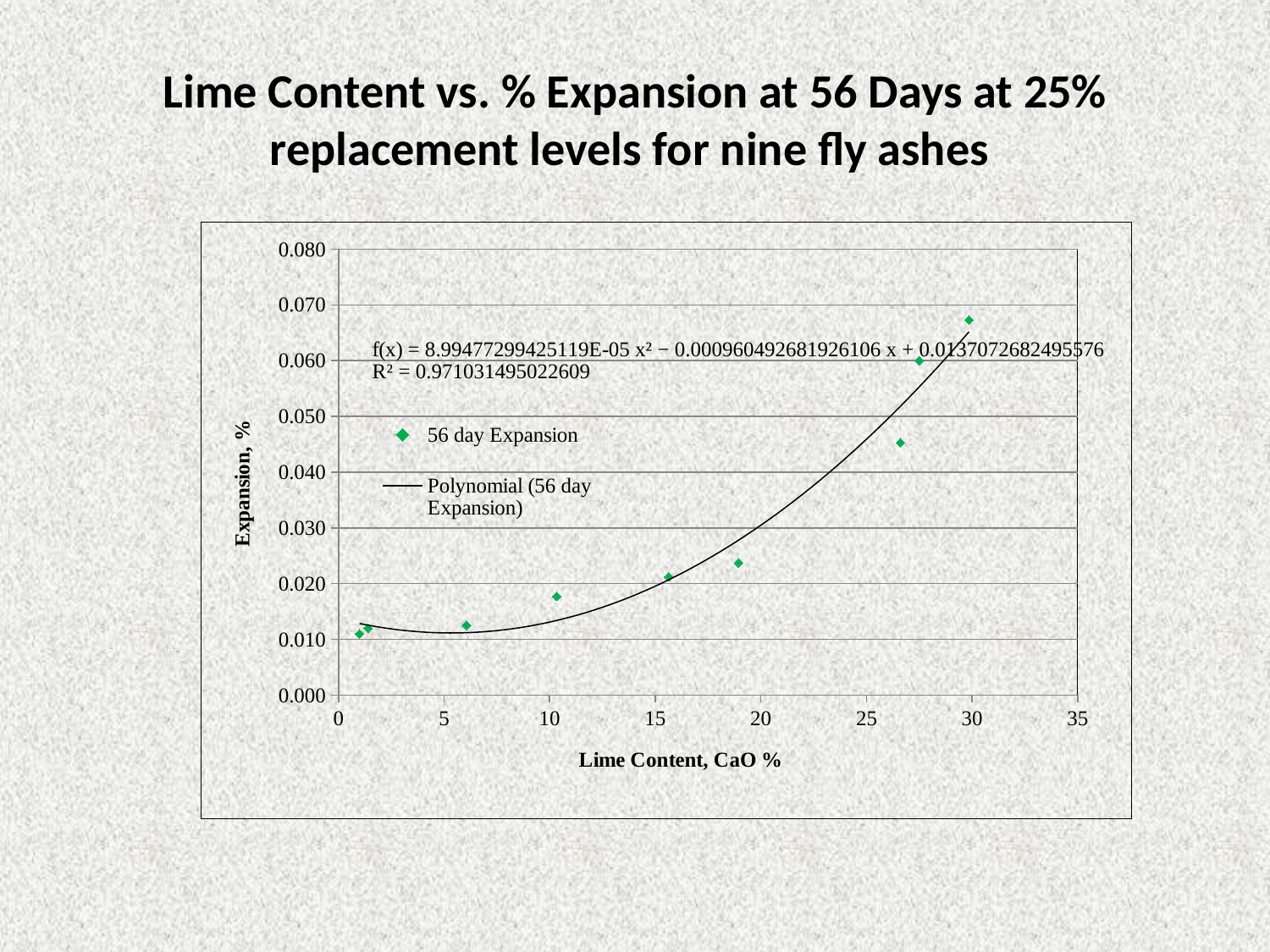
How many entries does the legend list? 2 Is the expansion value for the data point near 10% lime content greater or less than 0.020? less What kind of chart is shown on the slide? Scatter chart What is the title of the y axis? Expansion, % What R² value is printed on the chart for the polynomial trendline? 0.971031495022609 Do the expansion values generally rise or fall as lime content increases along the x axis? Rise Is the expansion value for the data point near 19% lime content greater or less than 0.030? less Is the highest plotted expansion value greater or less than 0.060? greater How many data points are plotted for the 56 day Expansion series? 9 What is the title of the x axis? Lime Content, CaO %